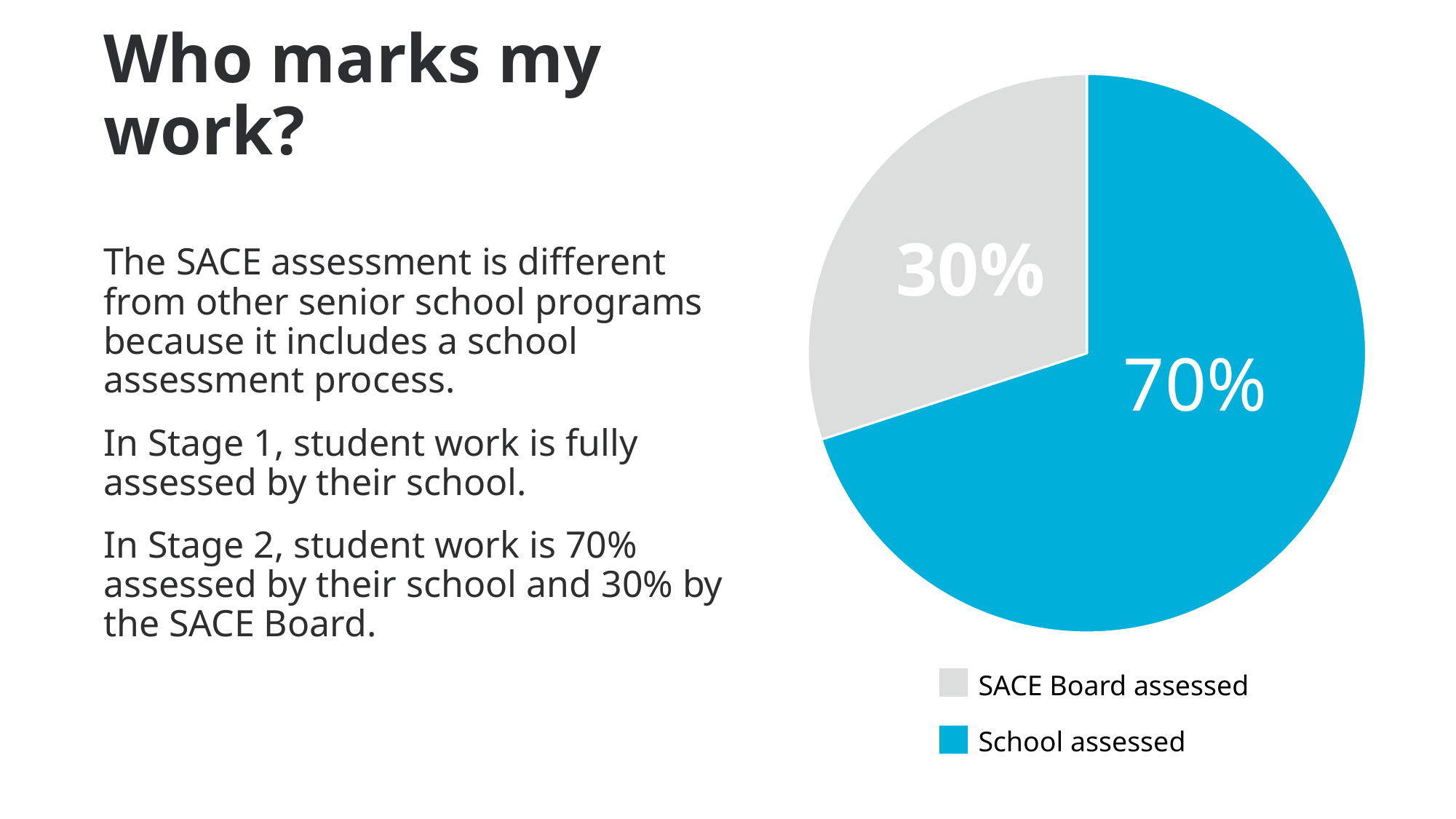
What percentage of the pie is SACE Board assessed? 30% Which slice of the pie is the smallest? SACE Board assessed How many entries does the legend list? 2 What kind of chart is shown on the slide? pie chart What colour is the SACE Board assessed slice? grey What percentage of the pie is School assessed? 70% Which slice of the pie is the largest? School assessed What is the difference in percentage points between the School assessed and SACE Board assessed slices? 40 Which is larger, the School assessed slice or the SACE Board assessed slice? School assessed What share of the pie does the SACE Board assessed slice represent? 30% How many slices does the pie chart have? 2 What colour is the School assessed slice? blue